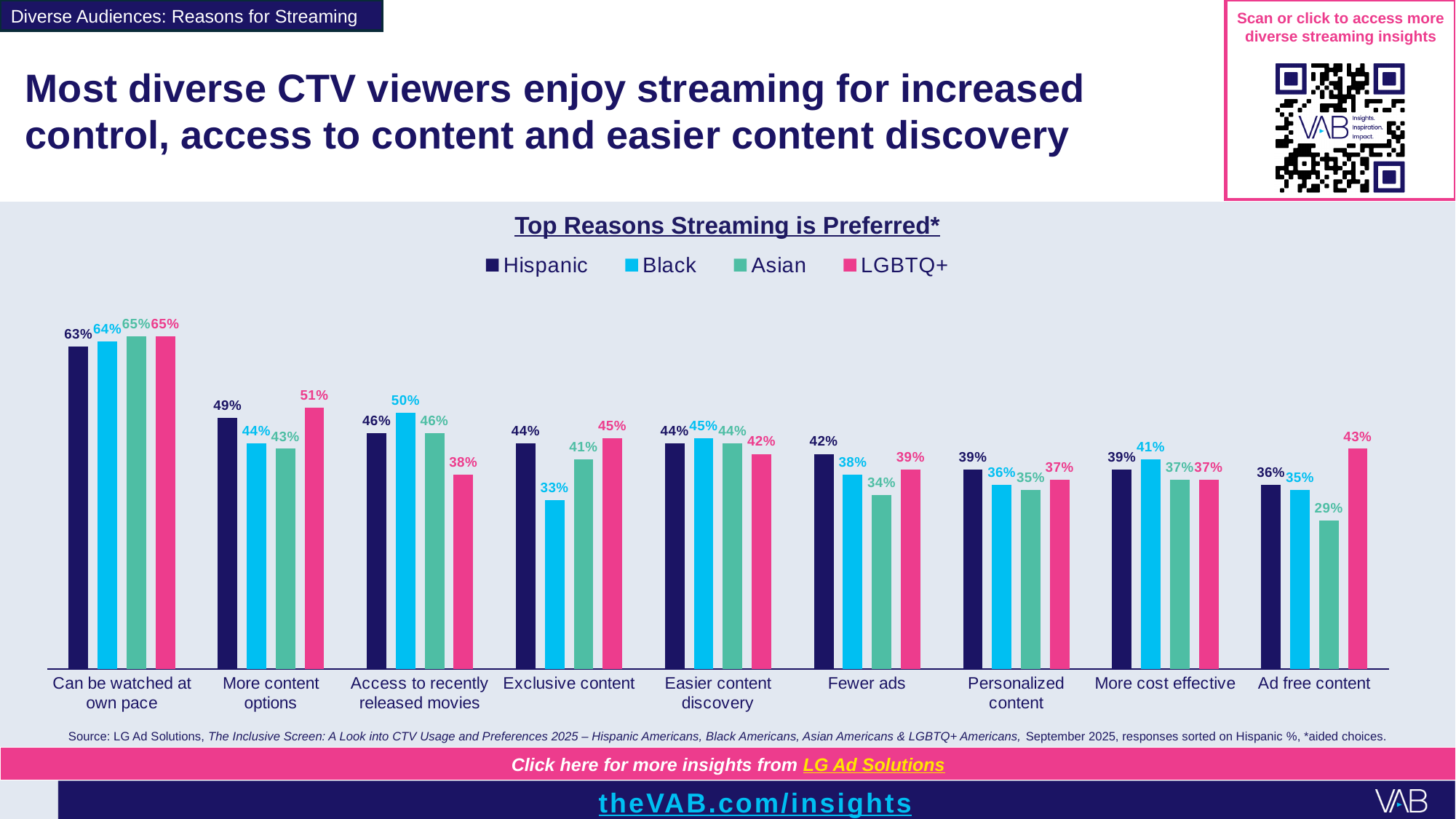
For 'Access to recently released movies', which is larger: the Black value or the LGBTQ+ value? Black How many series does the legend list? 4 How many categories are shown on the x axis? 9 What is the difference between the LGBTQ+ and Asian values for 'Ad free content'? 14% Which category has the highest value for Black viewers? Can be watched at own pace What is the value for LGBTQ+ viewers for 'More content options'? 51% What is the value for Hispanic viewers for 'Can be watched at own pace'? 63% What is the value for Black viewers for 'Exclusive content'? 33% What kind of chart is shown on the slide? Bar chart Which category has the lowest value for Asian viewers? Ad free content What is the title of the chart? Top Reasons Streaming is Preferred* What is the value for Asian viewers for 'Ad free content'? 29%